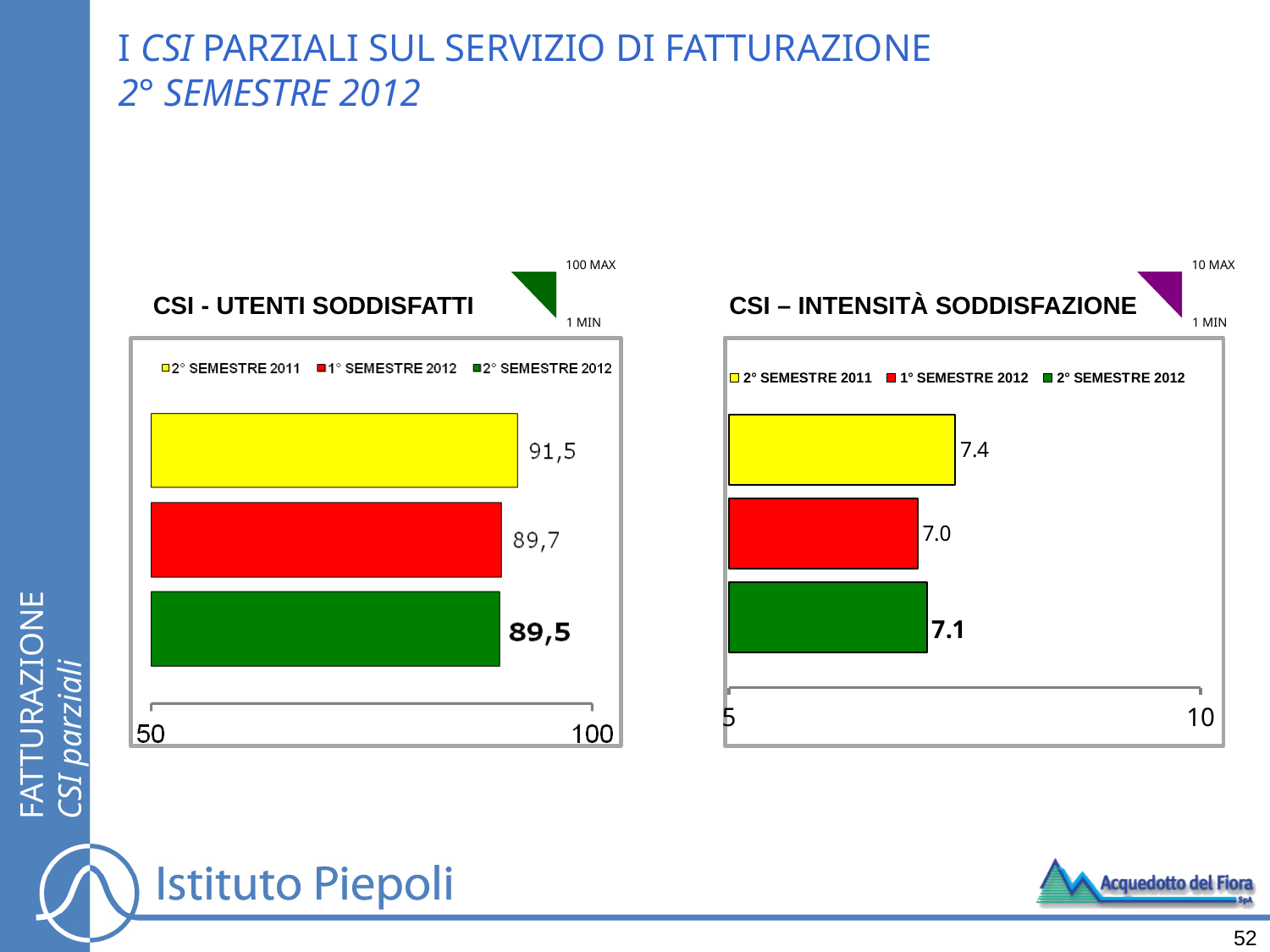
In the chart 'CSI – INTENSITÀ SODDISFAZIONE', which is larger: the value for 1° SEMESTRE 2012 or the value for 2° SEMESTRE 2012? 2° SEMESTRE 2012 In the chart 'CSI - UTENTI SODDISFATTI', what colour is the bar for 1° SEMESTRE 2012? Red How many series does the legend of the chart 'CSI - UTENTI SODDISFATTI' list? 3 In the chart 'CSI – INTENSITÀ SODDISFAZIONE', what is the value for 2° SEMESTRE 2012? 7.1 In the chart 'CSI – INTENSITÀ SODDISFAZIONE', which series has the lowest value? 1° SEMESTRE 2012 What kind of chart is 'CSI – INTENSITÀ SODDISFAZIONE'? Bar chart In the chart 'CSI - UTENTI SODDISFATTI', what is the value for 2° SEMESTRE 2012? 89,5 In the chart 'CSI - UTENTI SODDISFATTI', what is the value for 2° SEMESTRE 2011? 91,5 In the chart 'CSI - UTENTI SODDISFATTI', which series has the highest value? 2° SEMESTRE 2011 In the chart 'CSI – INTENSITÀ SODDISFAZIONE', what is the value for 1° SEMESTRE 2012? 7.0 In the chart 'CSI - UTENTI SODDISFATTI', what is the difference between the 2° SEMESTRE 2011 value and the 1° SEMESTRE 2012 value? 1,8 In the chart 'CSI – INTENSITÀ SODDISFAZIONE', what is the difference between the 2° SEMESTRE 2011 value and the 1° SEMESTRE 2012 value? 0.4